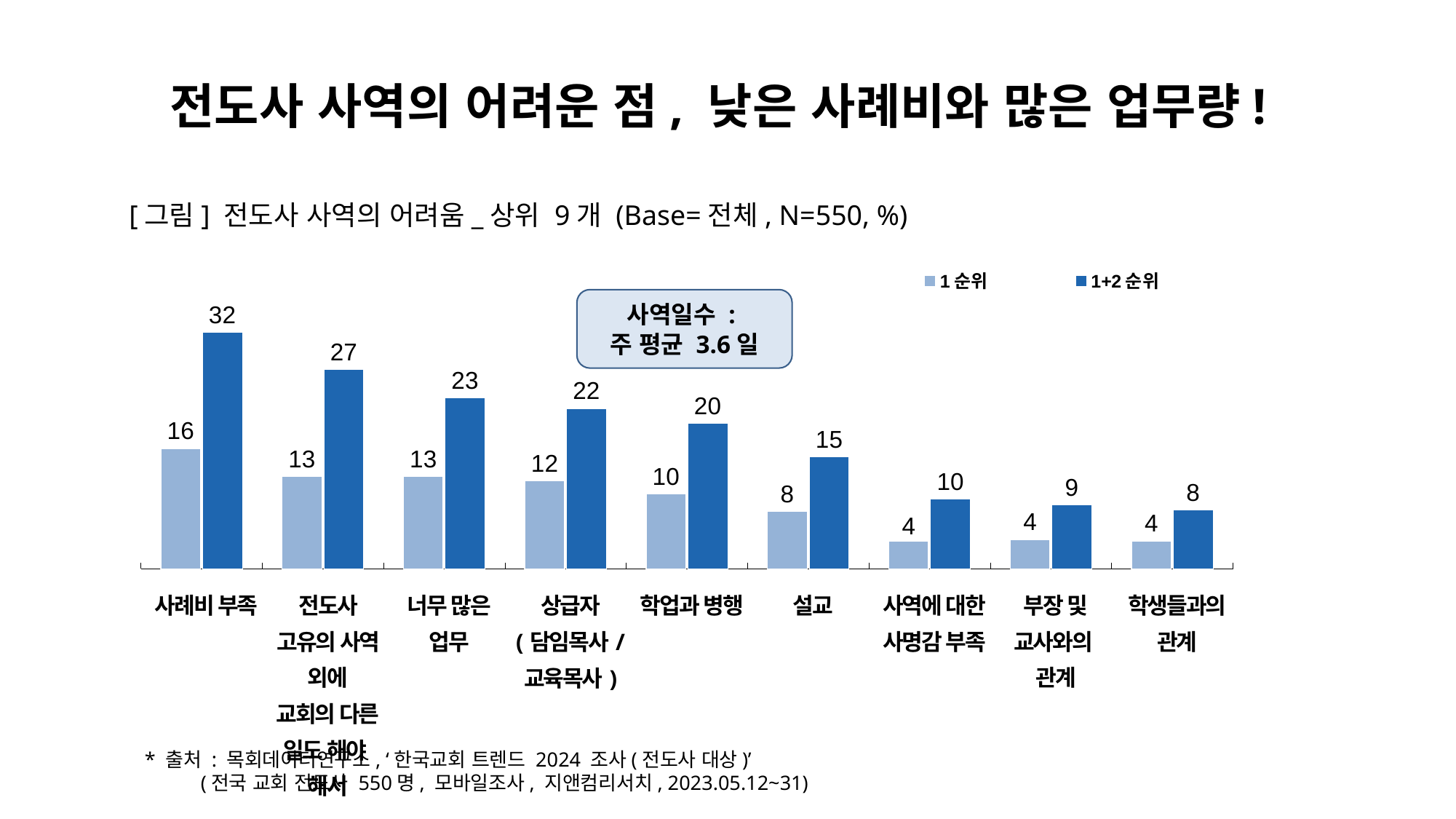
What is the 1 순위 value for 학업과 병행? 10 What is the 1+2 순위 value for 사례비 부족? 32 Do the 1+2 순위 values rise or fall from left to right along the x axis? fall Which category has the highest 1+2 순위 value? 사례비 부족 How many categories are shown on the x axis? 9 What kind of chart is shown on the slide? bar chart What is the average number of ministry days per week shown in the callout box on the chart? 3.6일 What is the 1+2 순위 value for 설교? 15 Which category has the lowest 1+2 순위 value? 학생들과의 관계 What is the difference between the 1+2 순위 and 1 순위 values for 너무 많은 업무? 10 How many series does the legend list? 2 Which is larger: the 1+2 순위 value for 상급자(담임목사/교육목사) or the 1+2 순위 value for 학업과 병행? 상급자(담임목사/교육목사)